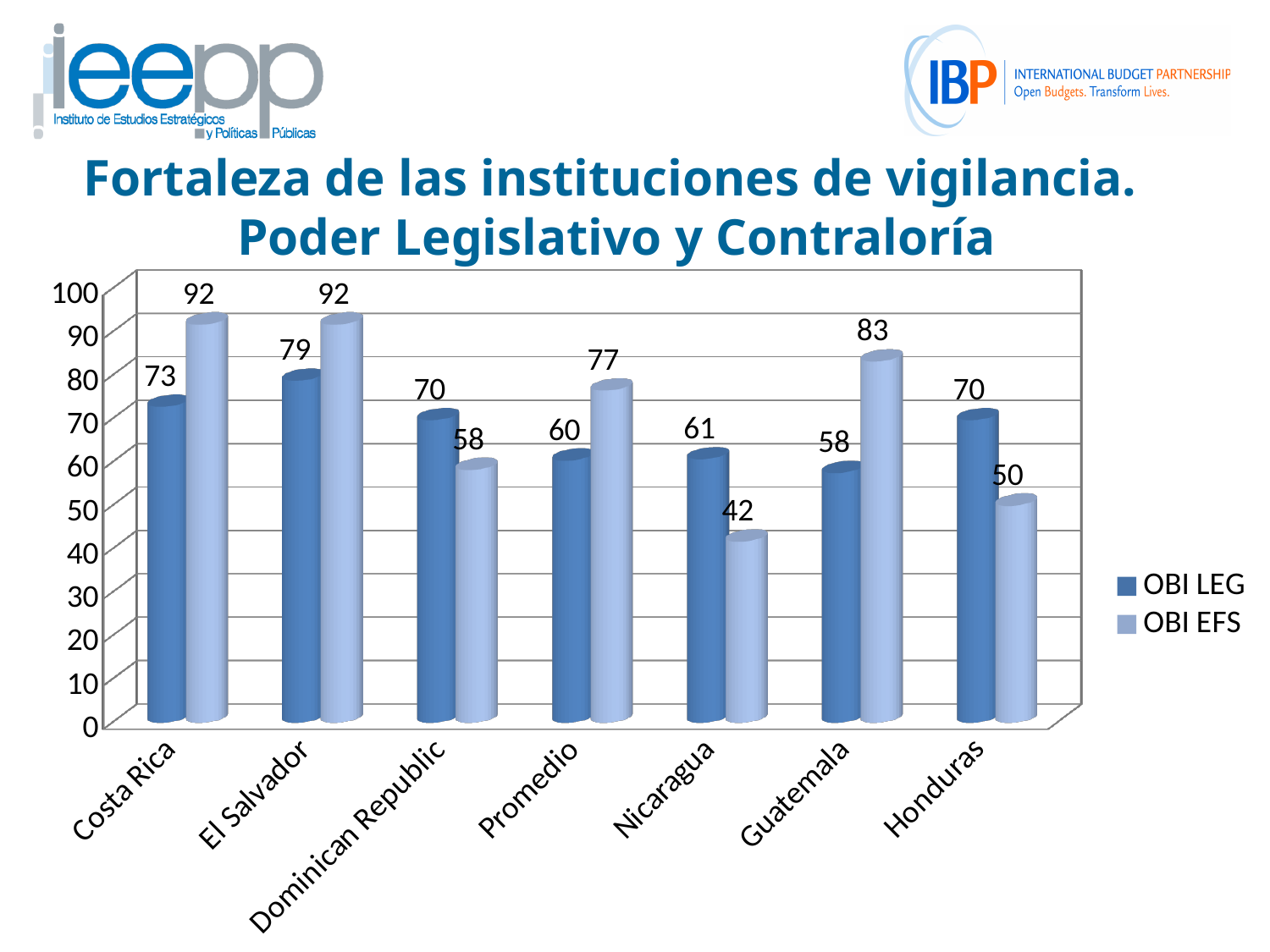
How many categories are shown on the x axis? 7 What is the OBI EFS value for Guatemala? 83 For Honduras, which is larger: OBI LEG or OBI EFS? OBI LEG Which category has the highest OBI LEG value? El Salvador What is the OBI LEG value for Costa Rica? 73 What is the OBI EFS value for Nicaragua? 42 How many series does the legend list? 2 Which category has the lowest OBI EFS value? Nicaragua What are the two series named in the legend? OBI LEG and OBI EFS Which category has the lowest OBI LEG value? Guatemala What kind of chart is shown on the slide? Bar chart What is the difference between the OBI EFS and OBI LEG values for Guatemala? 25